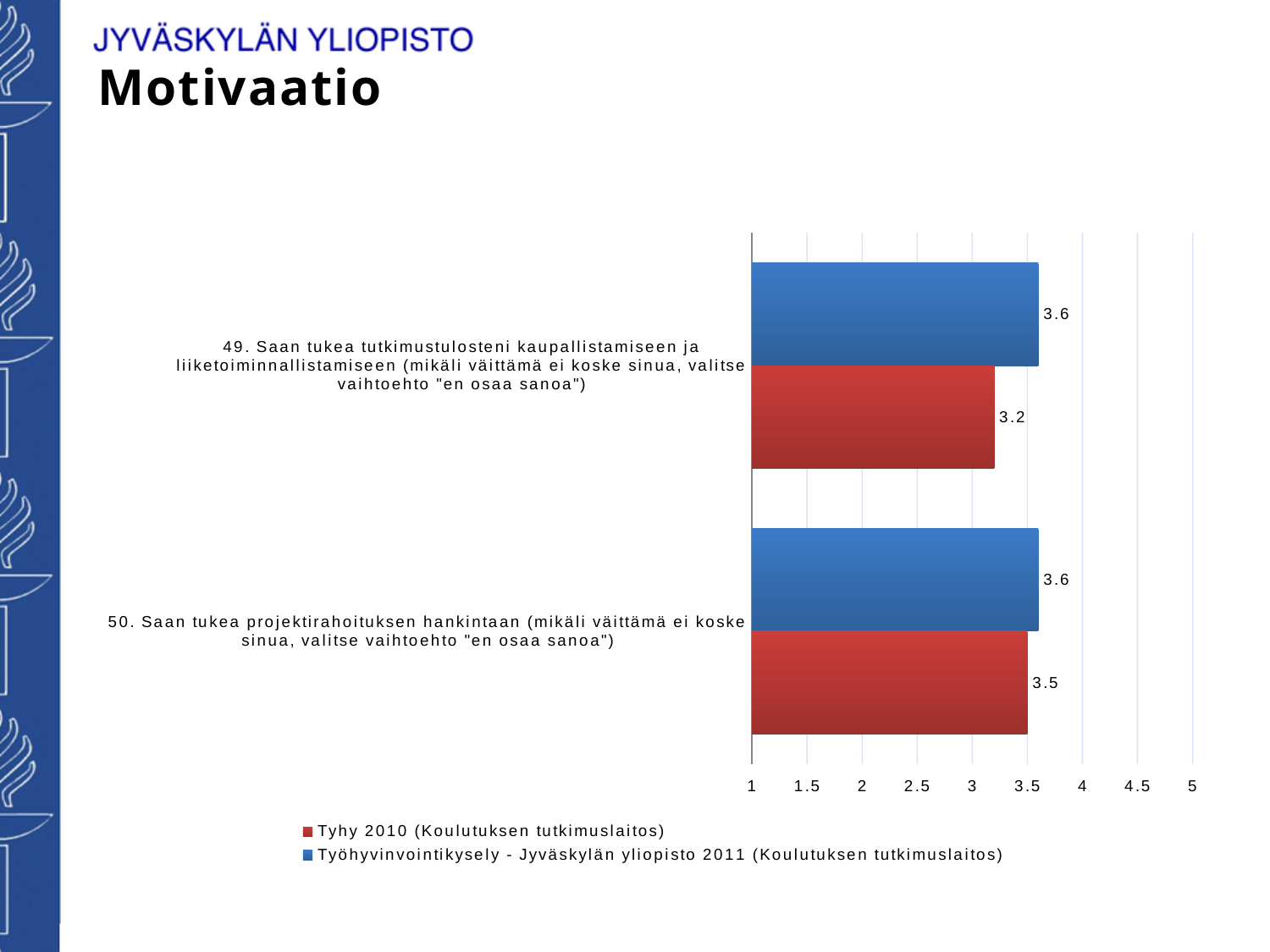
What kind of chart is shown on the slide? Bar chart For statement 49, which series has the larger value, Tyhy 2010 or Työhyvinvointikysely 2011? Työhyvinvointikysely - Jyväskylän yliopisto 2011 What is the difference between the 2011 and the Tyhy 2010 values for statement 49? 0.4 What is the difference between the 2011 and the Tyhy 2010 values for statement 50? 0.1 Which colour represents the Tyhy 2010 series? Red What is the Tyhy 2010 value for statement 50 (Saan tukea projektirahoituksen hankintaan)? 3.5 Which statement has the lower Tyhy 2010 value, 49 or 50? 49 What is the Työhyvinvointikysely - Jyväskylän yliopisto 2011 value for statement 50? 3.6 How many series does the legend list? 2 What is the Tyhy 2010 value for statement 49 (Saan tukea tutkimustulosteni kaupallistamiseen ja liiketoiminnallistamiseen)? 3.2 How many categories (statements) are plotted on the chart? 2 What is the Työhyvinvointikysely - Jyväskylän yliopisto 2011 value for statement 49? 3.6